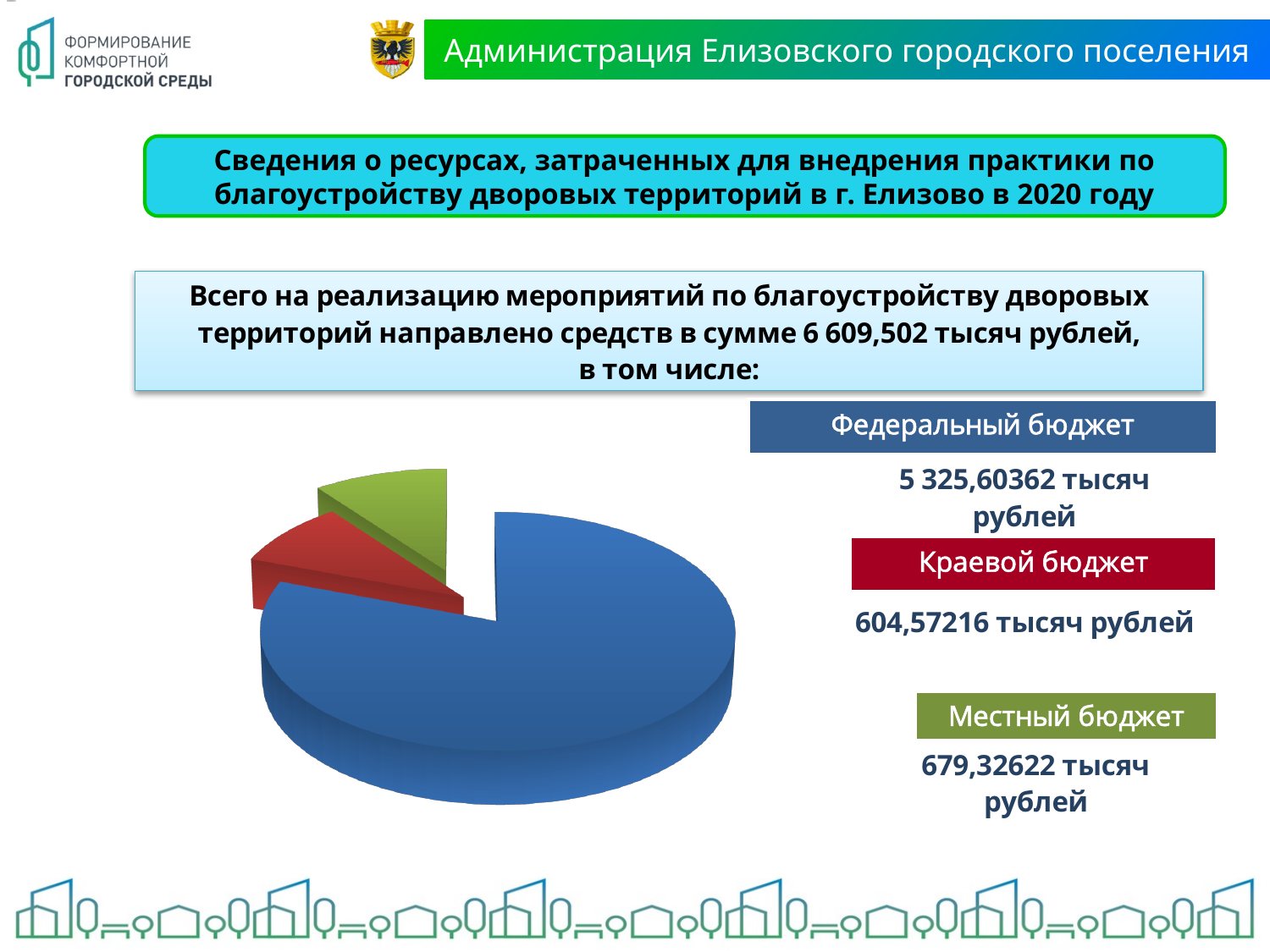
Which budget source accounts for the largest slice of the pie? Федеральный бюджет Which is larger, the amount for Краевой бюджет or for Местный бюджет? Местный бюджет What kind of chart is shown on the slide? Pie chart What is the total amount of funds directed to the improvement of courtyard areas, according to the slide? 6 609,502 тысяч рублей What is the difference between the amounts for Федеральный бюджет and Краевой бюджет? 4 721,03146 тысяч рублей Which budget source accounts for the smallest slice of the pie? Краевой бюджет What is the difference between the amounts for Местный бюджет and Краевой бюджет? 74,75406 тысяч рублей How many slices does the pie chart have? 3 What colour is the slice representing Федеральный бюджет? Blue What amount is shown for Краевой бюджет? 604,57216 тысяч рублей What amount is shown for Федеральный бюджет? 5 325,60362 тысяч рублей What amount is shown for Местный бюджет? 679,32622 тысяч рублей